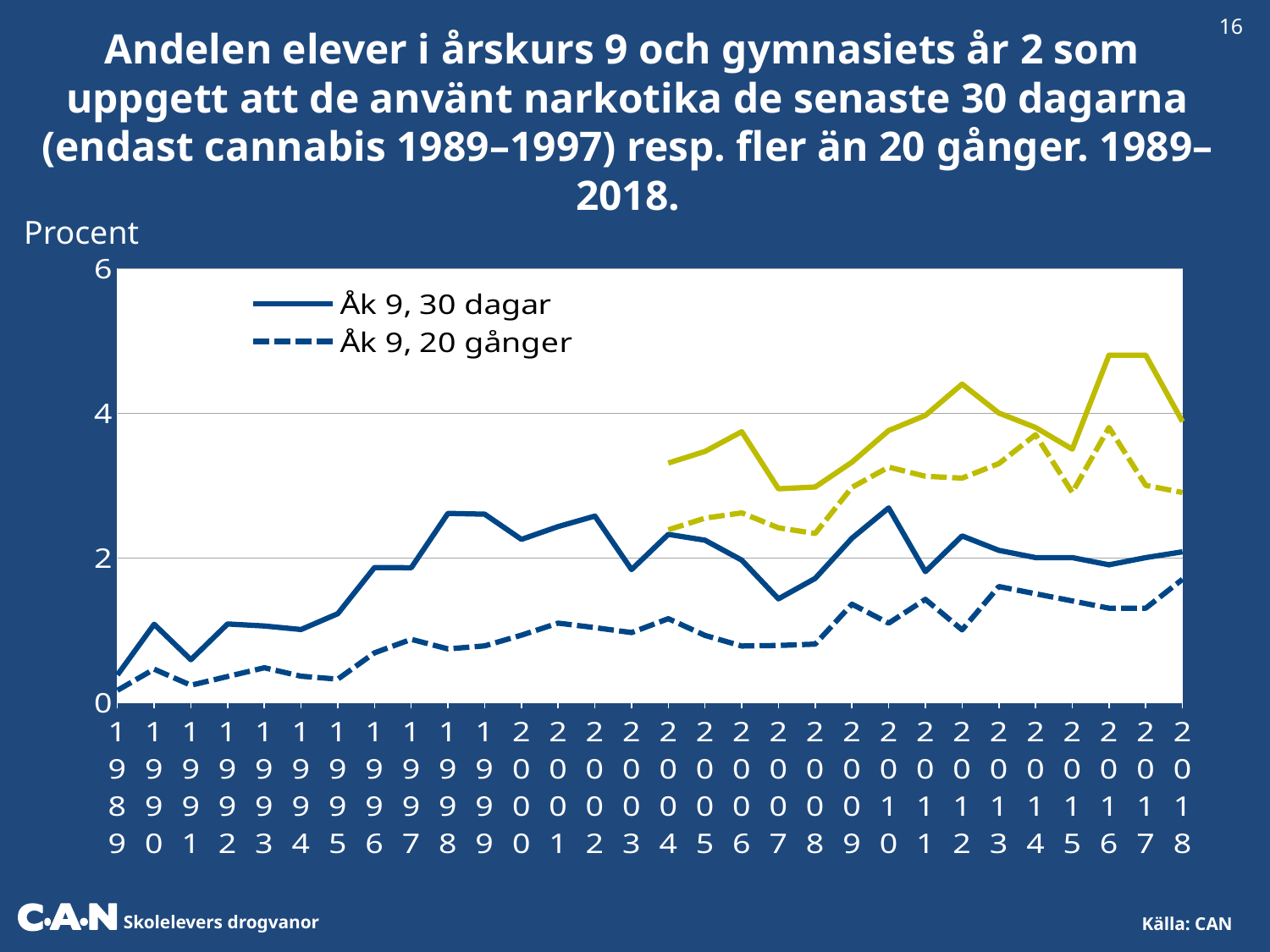
Is the value for Åk 9, 30 dagar in 2010 greater or less than 2? greater Is the value of the solid yellow line in 2007 greater or less than 4? less In which year is the Åk 9, 30 dagar line at its lowest? 1989 Does the Åk 9, 30 dagar line rise or fall between 1989 and 1998? rise How many years are shown along the x axis? 30 Is the value for Åk 9, 20 gånger in 2018 greater or less than 2? less How many series does the legend list? 2 What kind of chart is shown on the slide? line chart In 2018, which is higher: the solid yellow line or the Åk 9, 30 dagar line? the solid yellow line What is the label on the y axis? Procent